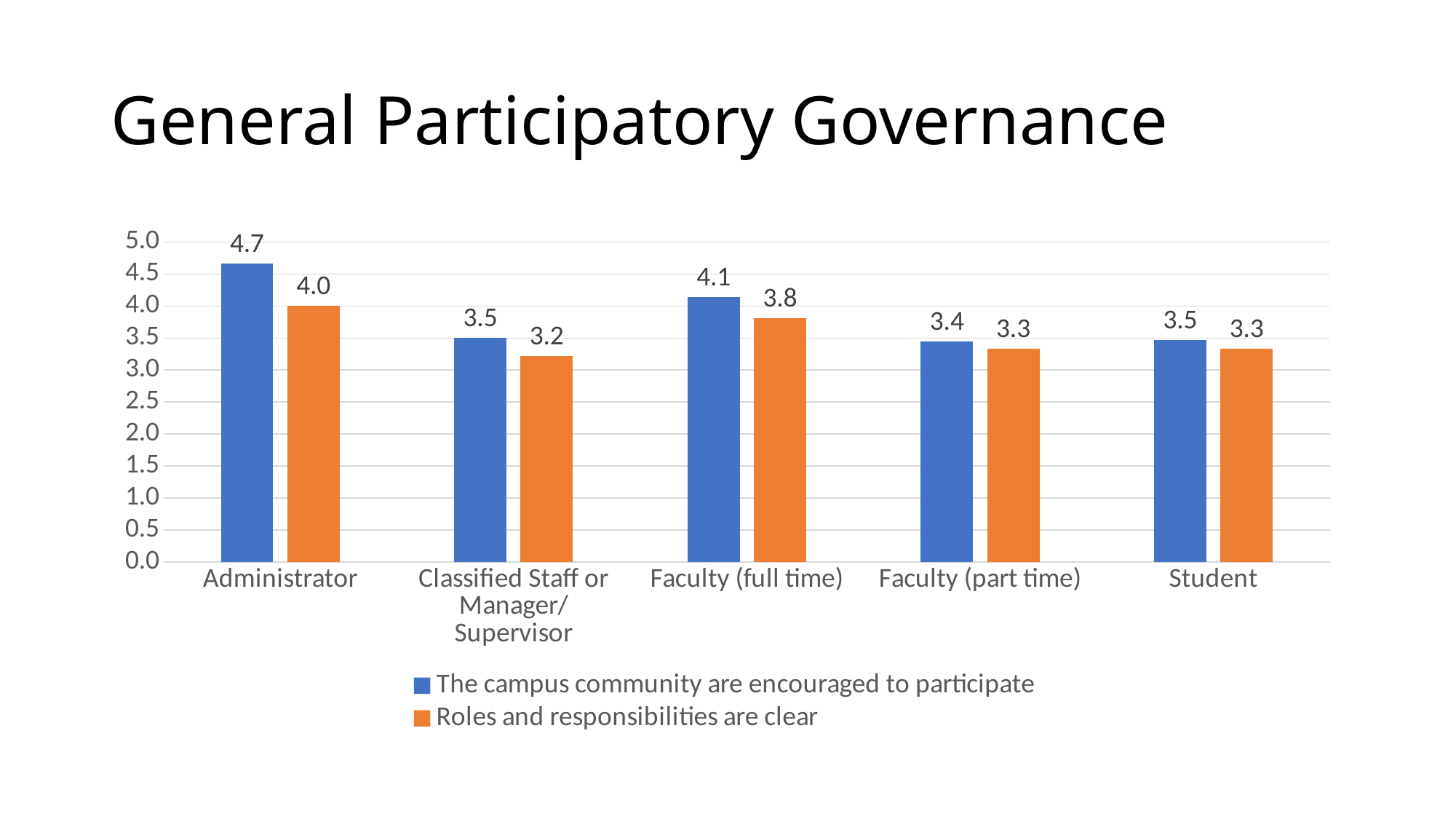
What is the value for Administrator in the series 'The campus community are encouraged to participate'? 4.7 What kind of chart is shown on the slide? Bar chart Which is larger for Faculty (full time): 'The campus community are encouraged to participate' or 'Roles and responsibilities are clear'? The campus community are encouraged to participate What colour are the bars for the series 'Roles and responsibilities are clear'? Orange What is the value for Student in the series 'The campus community are encouraged to participate'? 3.5 How many categories are shown on the x axis? 5 Which category has the highest value in the series 'The campus community are encouraged to participate'? Administrator Is the value for Faculty (part time) in the series 'Roles and responsibilities are clear' greater or less than 3.0? greater What is the difference between the two series values for Administrator? 0.7 How many series does the legend list? 2 Which category has the lowest value in the series 'Roles and responsibilities are clear'? Classified Staff or Manager/Supervisor What is the value for Faculty (full time) in the series 'Roles and responsibilities are clear'? 3.8